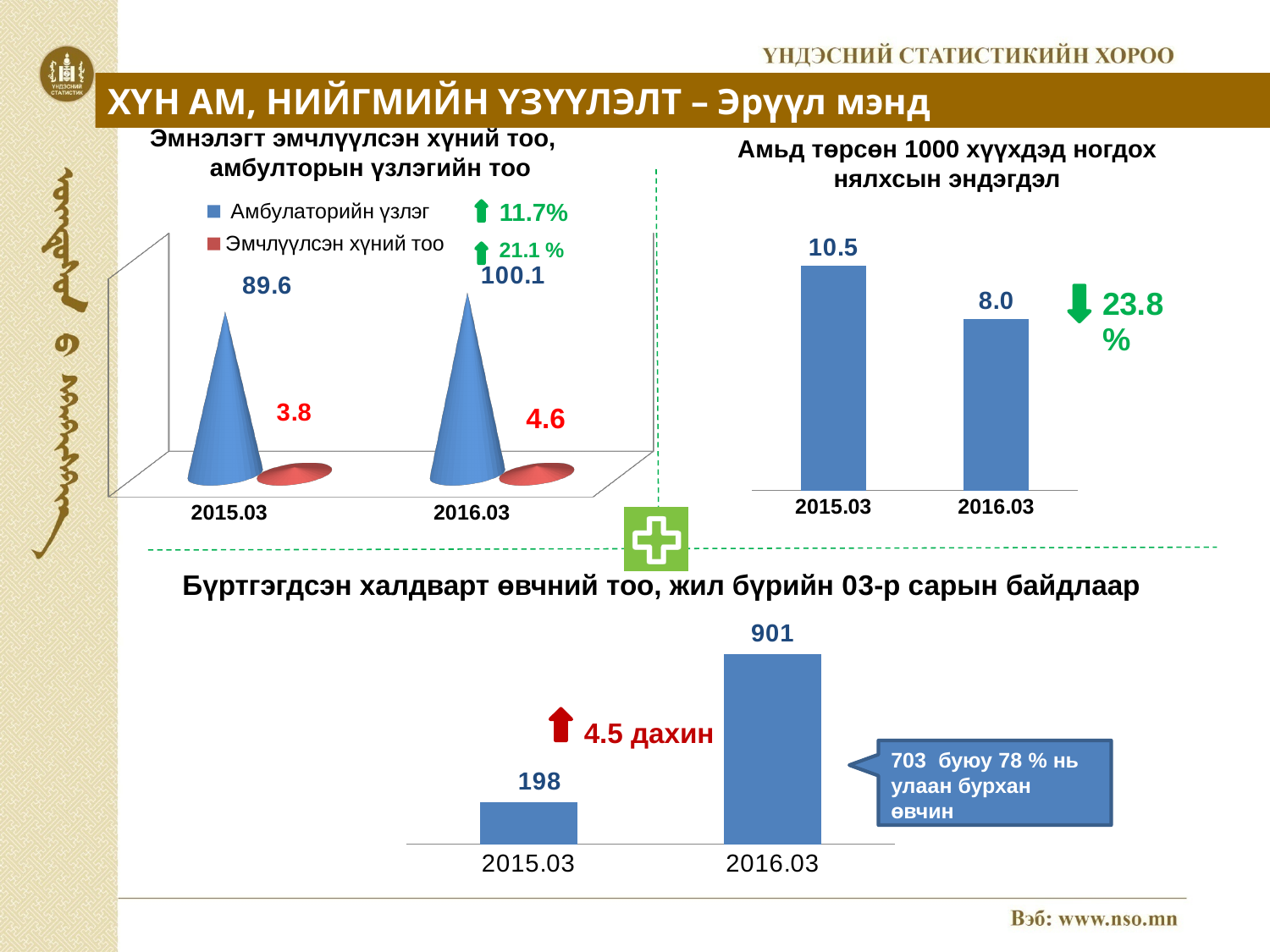
In the top-right chart 'Амьд төрсөн 1000 хүүхдэд ногдох нялхсын эндэгдэл', what is the difference between the 2015.03 and 2016.03 values? 2.5 In the top-left chart 'Эмнэлэгт эмчлүүлсэн хүний тоо, амбулторын үзлэгийн тоо', what is the value of Эмчлүүлсэн хүний тоо for 2015.03? 3.8 In the bottom chart 'Бүртгэгдсэн халдварт өвчний тоо, жил бүрийн 03-р сарын байдлаар', what is the value for 2016.03? 901 In the bottom chart 'Бүртгэгдсэн халдварт өвчний тоо, жил бүрийн 03-р сарын байдлаар', what is the difference between the 2016.03 and 2015.03 values? 703 In the top-left chart 'Эмнэлэгт эмчлүүлсэн хүний тоо, амбулторын үзлэгийн тоо', what is the value of Амбулаторийн үзлэг for 2016.03? 100.1 In the top-left chart 'Эмнэлэгт эмчлүүлсэн хүний тоо, амбулторын үзлэгийн тоо', does Эмчлүүлсэн хүний тоо rise or fall from 2015.03 to 2016.03? rise In the top-right chart 'Амьд төрсөн 1000 хүүхдэд ногдох нялхсын эндэгдэл', what percentage change is shown next to the bars? 23.8% What kind of chart is the bottom chart 'Бүртгэгдсэн халдварт өвчний тоо, жил бүрийн 03-р сарын байдлаар'? bar chart In the top-left chart 'Эмнэлэгт эмчлүүлсэн хүний тоо, амбулторын үзлэгийн тоо', how many series does the legend list? 2 In the top-right chart 'Амьд төрсөн 1000 хүүхдэд ногдох нялхсын эндэгдэл', what is the value for 2015.03? 10.5 In the top-left chart 'Эмнэлэгт эмчлүүлсэн хүний тоо, амбулторын үзлэгийн тоо', by how much did Амбулаторийн үзлэг increase from 2015.03 to 2016.03? 10.5 In the top-right chart 'Амьд төрсөн 1000 хүүхдэд ногдох нялхсын эндэгдэл', which year has the lowest value? 2016.03